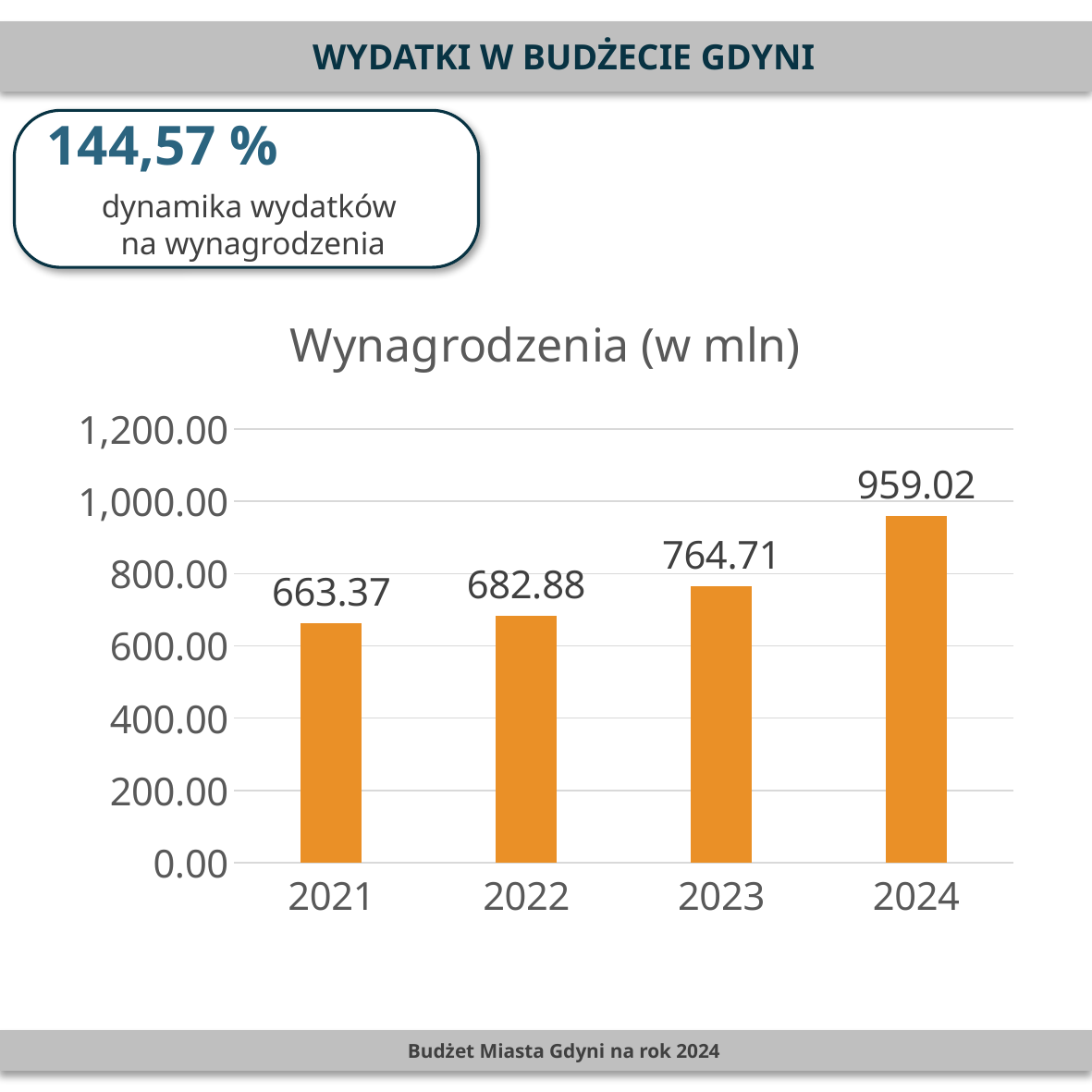
What is the value for 2021 in the Wynagrodzenia (w mln) chart? 663.37 What is the value for 2024 in the Wynagrodzenia (w mln) chart? 959.02 Which year has the lowest value in the Wynagrodzenia (w mln) chart? 2021 Is the value for 2024 in the Wynagrodzenia (w mln) chart greater or less than 800.00? greater What is the difference between the 2023 and 2022 values in the Wynagrodzenia (w mln) chart? 81.83 Do the values in the Wynagrodzenia (w mln) chart rise or fall from 2021 to 2024? rise What is the value for 2023 in the Wynagrodzenia (w mln) chart? 764.71 What kind of chart is the Wynagrodzenia (w mln) chart? bar chart Which year has the highest value in the Wynagrodzenia (w mln) chart? 2024 What is the difference between the 2024 and 2021 values in the Wynagrodzenia (w mln) chart? 295.65 How many years are shown on the x axis of the Wynagrodzenia (w mln) chart? 4 Which is larger in the Wynagrodzenia (w mln) chart, the value for 2022 or the value for 2023? 2023